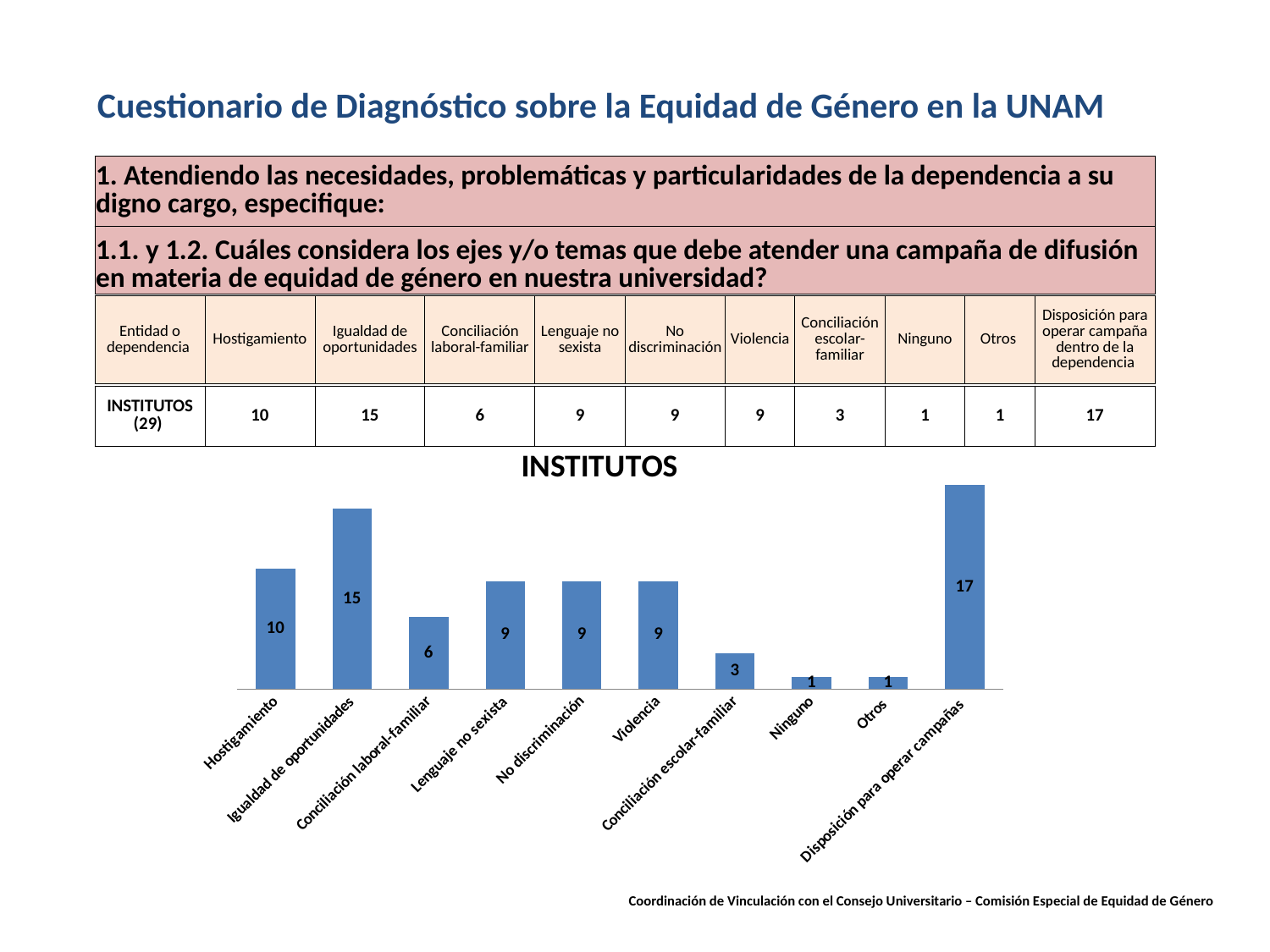
How many categories are shown in the INSTITUTOS chart? 10 Which category has the highest value in the INSTITUTOS chart? Disposición para operar campañas What is the difference between the values for Disposición para operar campañas and Igualdad de oportunidades in the INSTITUTOS chart? 2 Which is larger in the INSTITUTOS chart, Hostigamiento or Violencia? Hostigamiento What is the value for Igualdad de oportunidades in the INSTITUTOS chart? 15 What is the value for Conciliación laboral-familiar in the INSTITUTOS chart? 6 What is the difference between the values for Hostigamiento and Conciliación laboral-familiar in the INSTITUTOS chart? 4 What is the value for Conciliación escolar-familiar in the INSTITUTOS chart? 3 What kind of chart is the INSTITUTOS chart? Bar chart What is the title of the chart on the slide? INSTITUTOS How many categories in the INSTITUTOS chart have a value of 9? 3 What is the value for Hostigamiento in the INSTITUTOS chart? 10